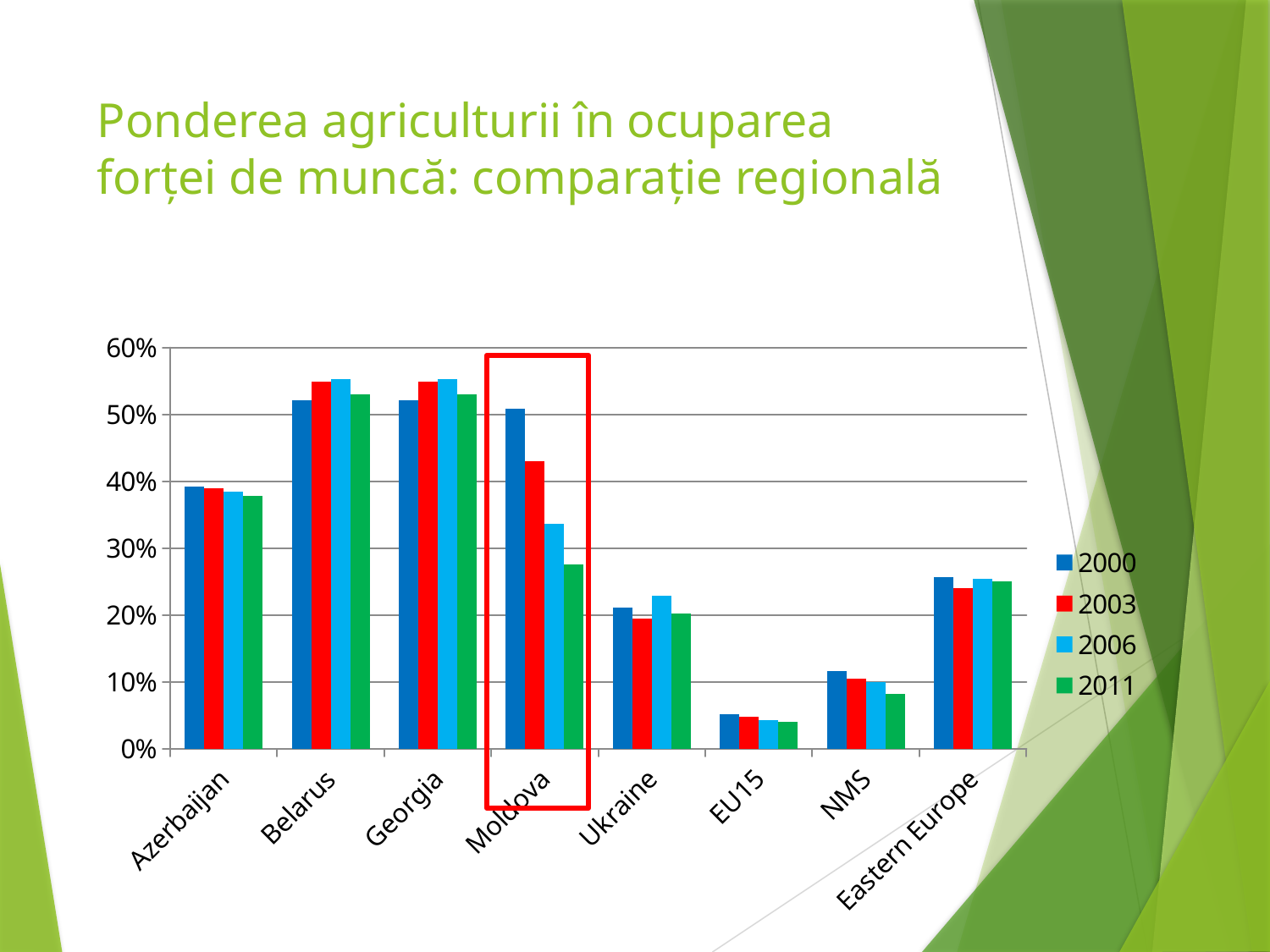
What kind of chart is shown on the slide? bar chart Is the value for Moldova in 2011 greater or less than 30%? less How many series does the chart's legend list? 4 Which is larger in 2011: the value for Belarus or the value for Moldova? Belarus Is the value for EU15 in 2000 greater or less than 10%? less Which category is highlighted with a red box on the chart? Moldova Which is larger for Moldova: the value for 2000 or the value for 2011? 2000 Is the value for Belarus in 2003 greater or less than 50%? greater Which category has the lowest values across all years in the chart? EU15 How many countries or regions are shown on the x axis of the chart? 8 Do the values for Moldova rise or fall from 2000 to 2011? fall